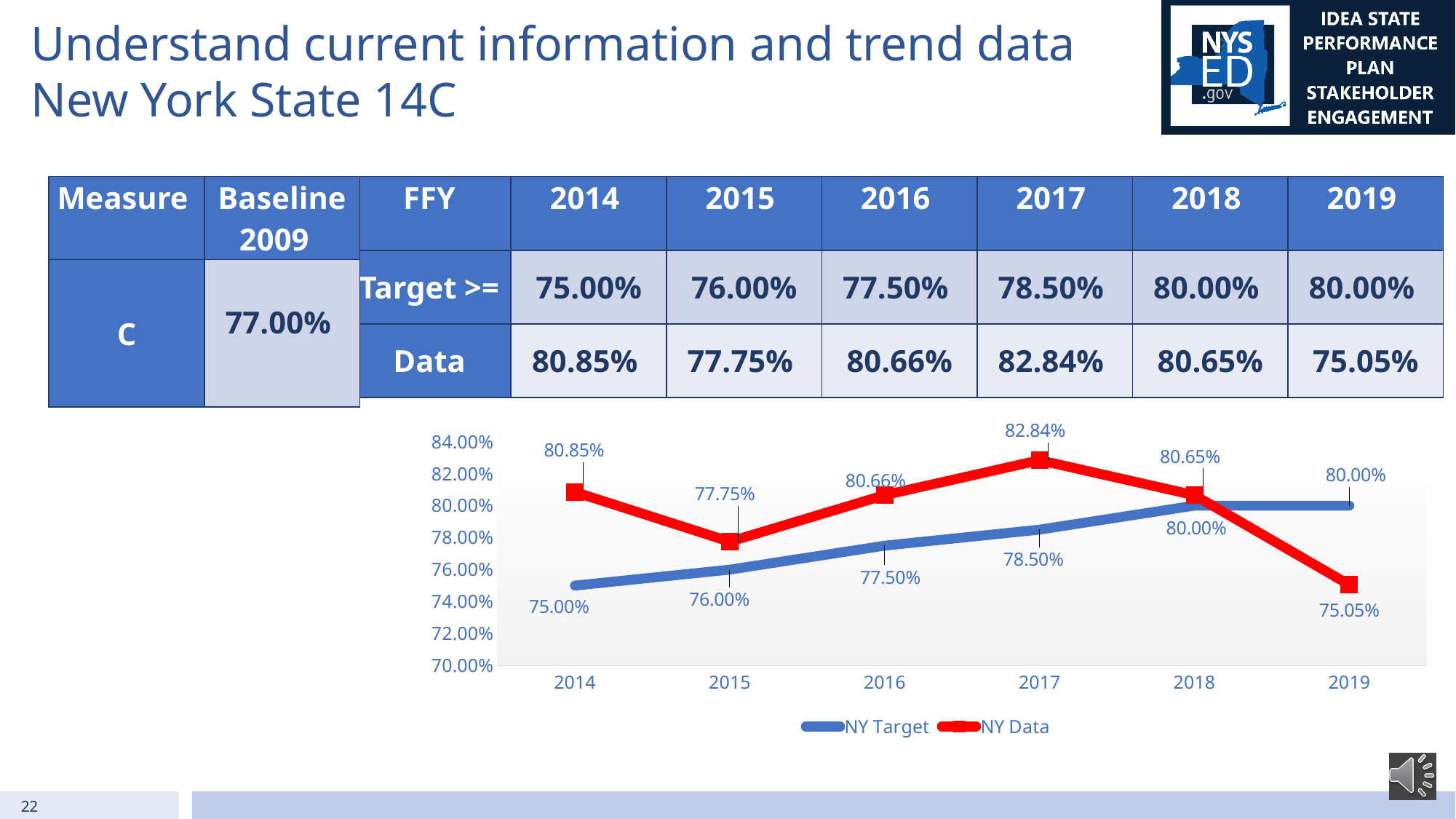
Is the NY Data value for 2015 greater or less than 76.00%? greater What is the NY Data value for 2019? 75.05% In which year is the NY Data value highest? 2017 Which is larger in 2019, NY Target or NY Data? NY Target How many series does the chart legend list? 2 What is the difference between NY Data and NY Target in 2014? 5.85% What is the NY Data value for 2017? 82.84% What kind of chart is shown on the slide? Line chart How many years are shown on the x axis of the chart? 6 In which year is the NY Data value lowest? 2019 What is the NY Target value for 2016? 77.50% Does the NY Target series rise or fall from 2014 to 2018? Rise